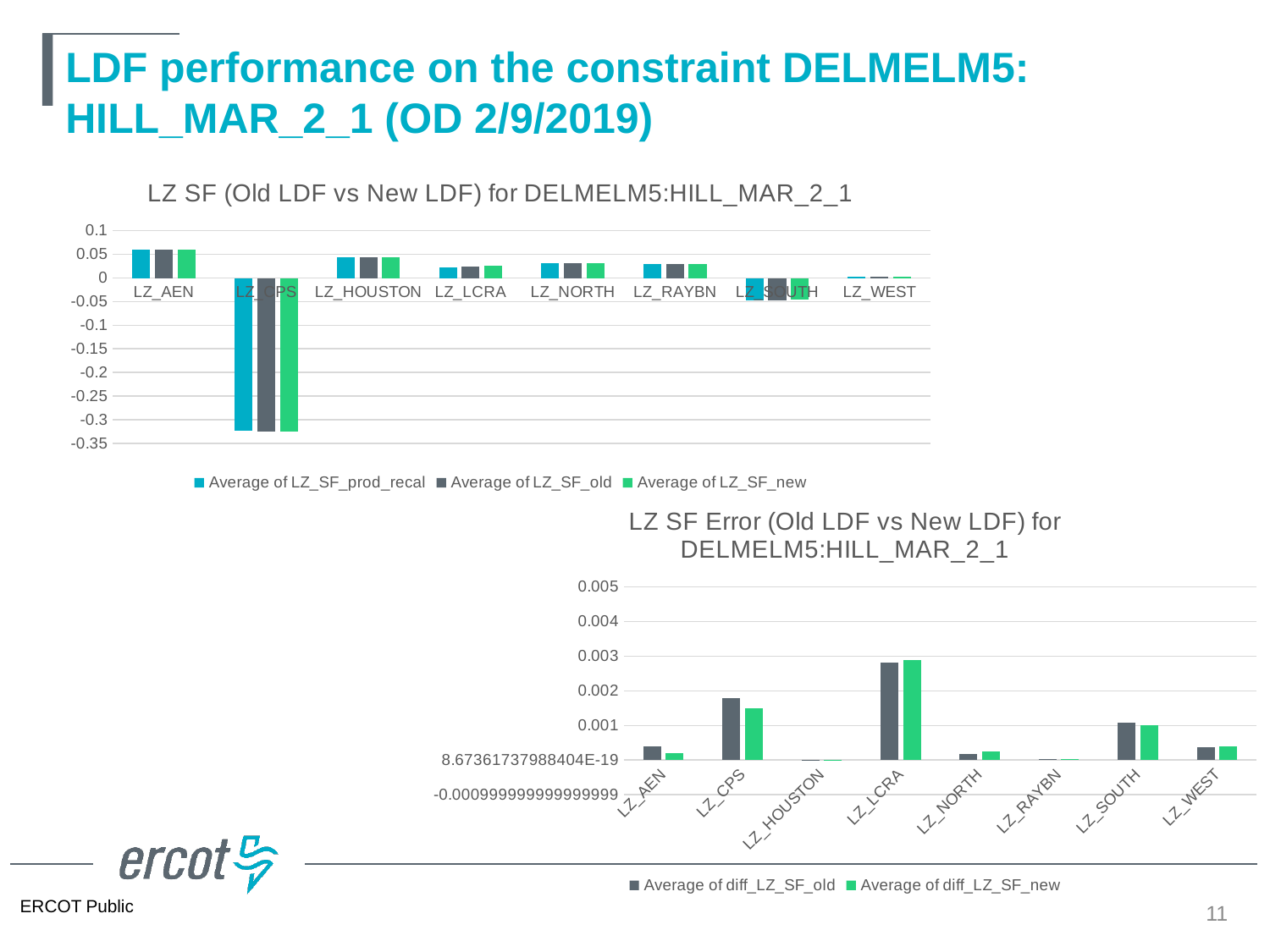
In the top chart (LZ SF), is the value for LZ_AEN (Average of LZ_SF_new) greater or less than 0.05? greater In the bottom chart (LZ SF Error), which is larger for Average of diff_LZ_SF_new: LZ_CPS or LZ_NORTH? LZ_CPS What type of chart is the top chart titled "LZ SF (Old LDF vs New LDF) for DELMELM5:HILL_MAR_2_1"? Bar chart In the top chart (LZ SF), which load zone has the highest values? LZ_AEN In the top chart (LZ SF), how many load zone categories are shown on the x axis? 8 In the top chart (LZ SF), how many series does the legend list? 3 In the top chart (LZ SF), is the value for LZ_CPS (Average of LZ_SF_old) greater or less than -0.3? less In the bottom chart (LZ SF Error), how many series does the legend list? 2 In the bottom chart (LZ SF Error), which load zone has the highest error values? LZ_LCRA In the bottom chart (LZ SF Error), is the value for LZ_LCRA (Average of diff_LZ_SF_old) greater or less than 0.002? greater In the top chart (LZ SF), which load zone has the lowest values? LZ_CPS In the top chart (LZ SF), which is larger for Average of LZ_SF_old: LZ_HOUSTON or LZ_LCRA? LZ_HOUSTON